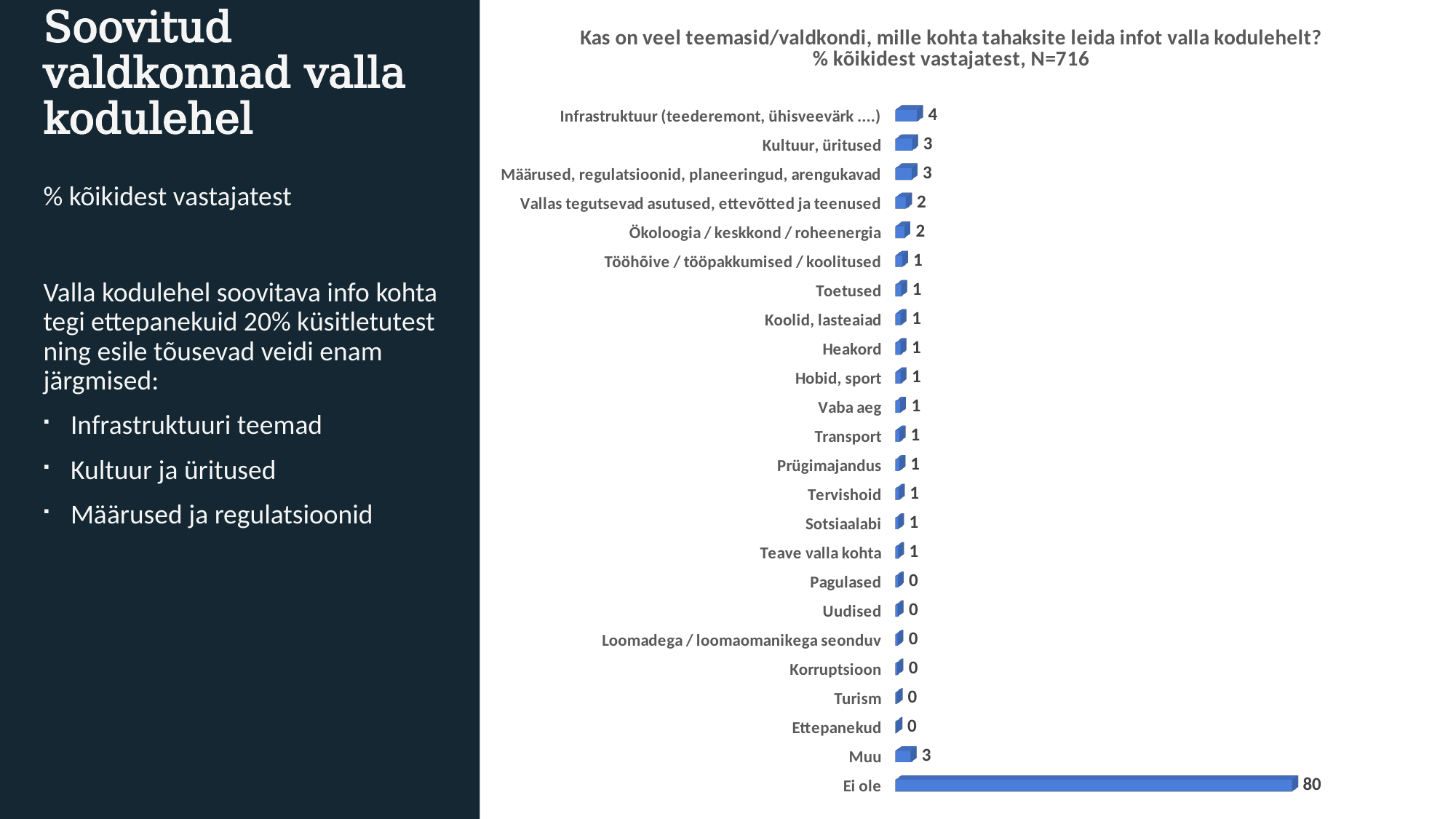
How many categories are shown in the chart? 24 What is the N (number of respondents) stated in the chart title? 716 What is the value for Kultuur, üritused? 3 What kind of chart is shown on the slide? bar chart What is the difference between the values for Infrastruktuur (teederemont, ühisveevärk ....) and Muu? 1 What is the value for Ökoloogia / keskkond / roheenergia? 2 What is the value for Turism? 0 Which category has the highest value? Ei ole What is the value for Infrastruktuur (teederemont, ühisveevärk ....)? 4 What is the difference between the values for Ei ole and Infrastruktuur (teederemont, ühisveevärk ....)? 76 Which is larger, the value for Kultuur, üritused or the value for Toetused? Kultuur, üritused What is the value for Ei ole? 80